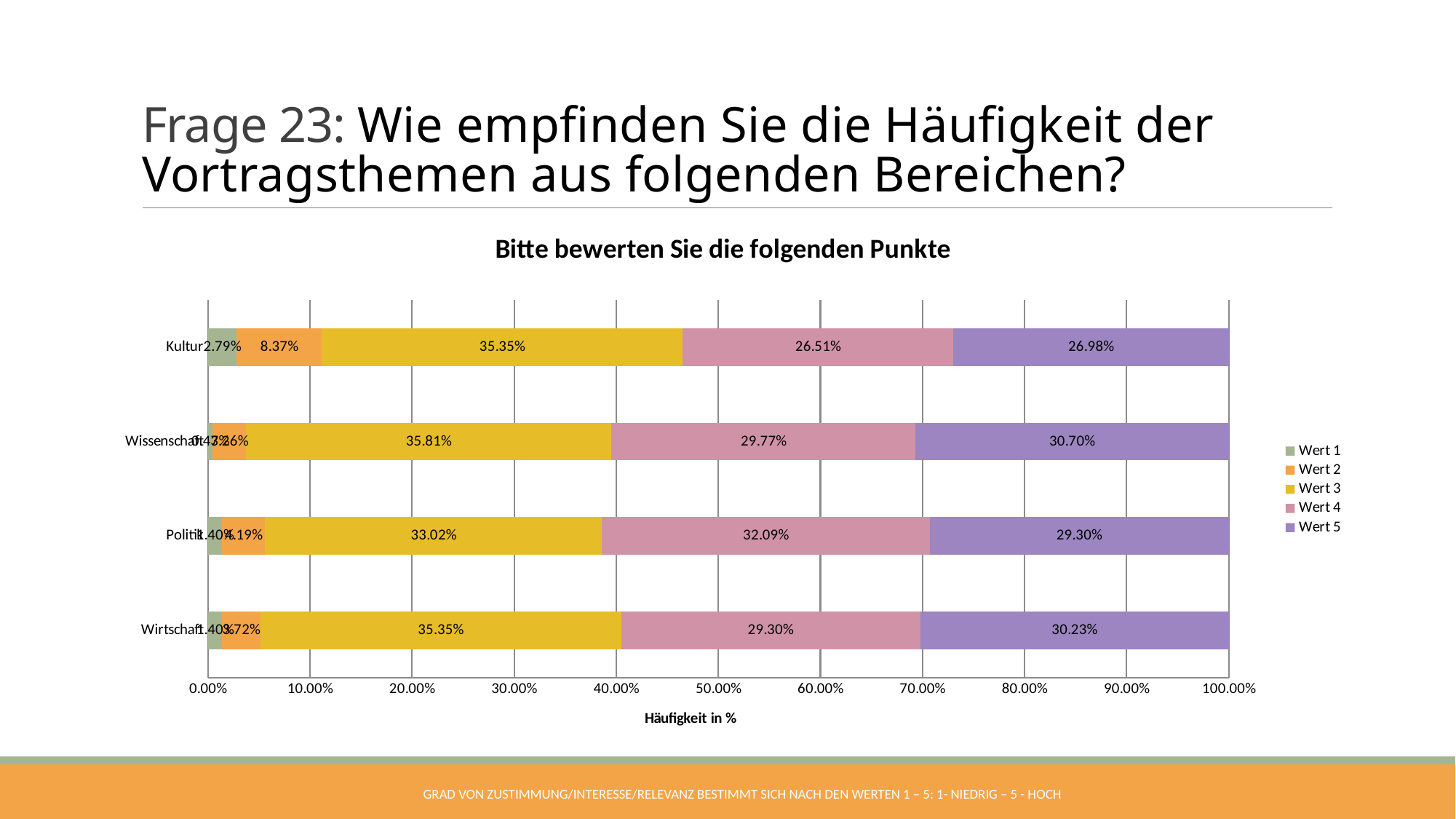
What is the value of Wert 2 for Kultur? 8.37% What is the difference between the Wert 3 values for Wissenschaft and Politik? 2.79% What is the value of Wert 4 for Politik? 32.09% What is the difference between Wert 5 and Wert 4 for Kultur? 0.47% What kind of chart is shown on the slide? Stacked bar chart What is the value of Wert 5 for Wissenschaft? 30.70% How many series does the legend list? 5 For Politik, which is larger: Wert 3 or Wert 4? Wert 3 What is the value of Wert 3 for Kultur? 35.35% Which category has the highest value for Wert 5? Wissenschaft Which category has the lowest value for Wert 4? Kultur How many categories are shown on the chart? 4